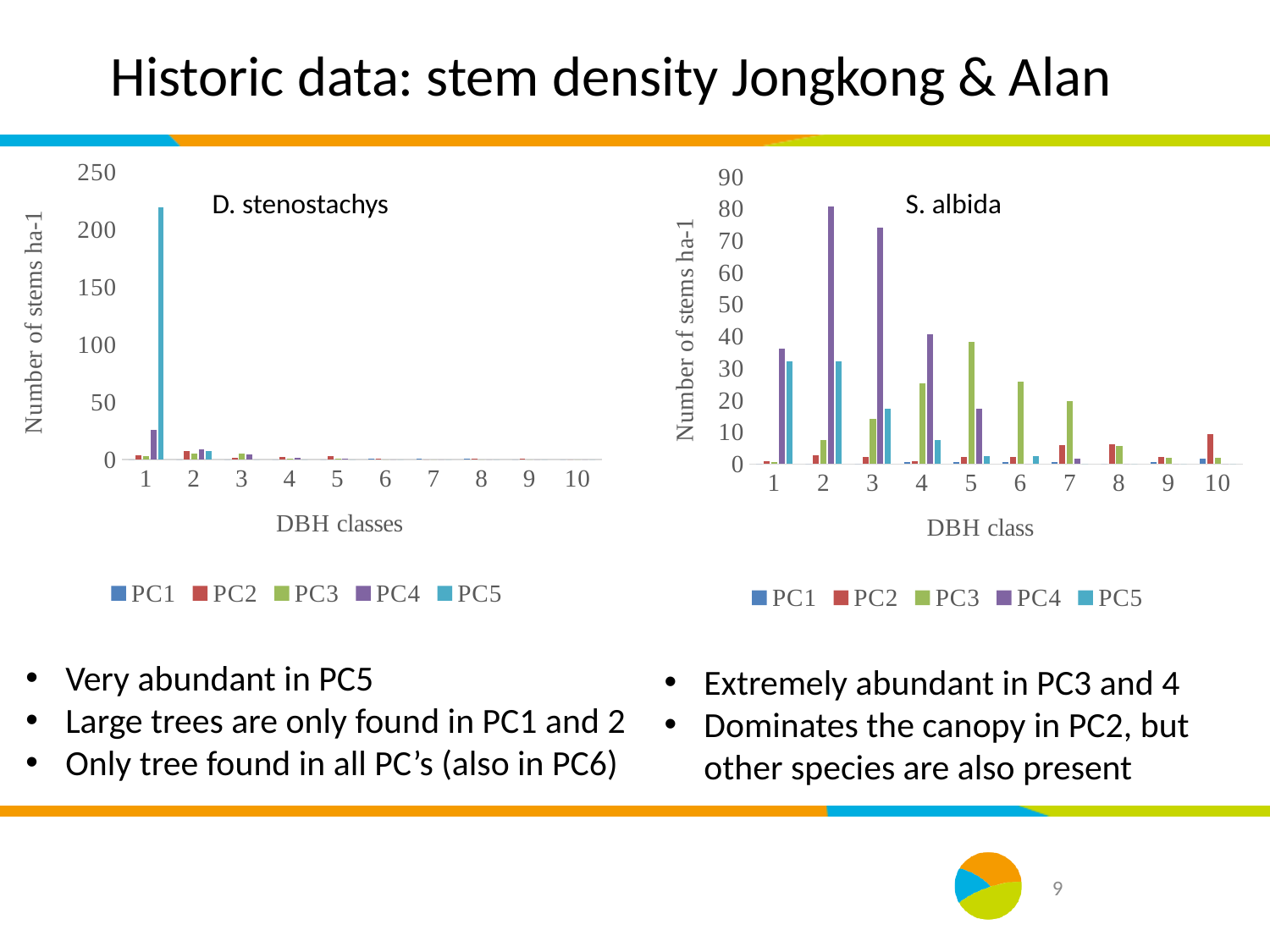
In the D. stenostachys chart, is the PC5 value for DBH class 1 greater or less than 200? greater In the S. albida chart, do the PC4 values rise or fall from DBH class 2 to DBH class 7? fall In the S. albida chart, is the PC4 value for DBH class 2 greater or less than 70? greater What kind of chart is the D. stenostachys chart on the left? bar chart In the S. albida chart, is the PC3 value for DBH class 6 greater or less than 30? less How many DBH classes are shown on the x axis of the D. stenostachys chart? 10 In the D. stenostachys chart, which series has the tallest bar? PC5 How many series does the legend of the S. albida chart list? 5 In the S. albida chart, which series has the tallest bar at DBH class 2? PC4 In the S. albida chart, which is larger: the PC4 value for DBH class 2 or the PC4 value for DBH class 3? DBH class 2 What is the y-axis title of the S. albida chart? Number of stems ha-1